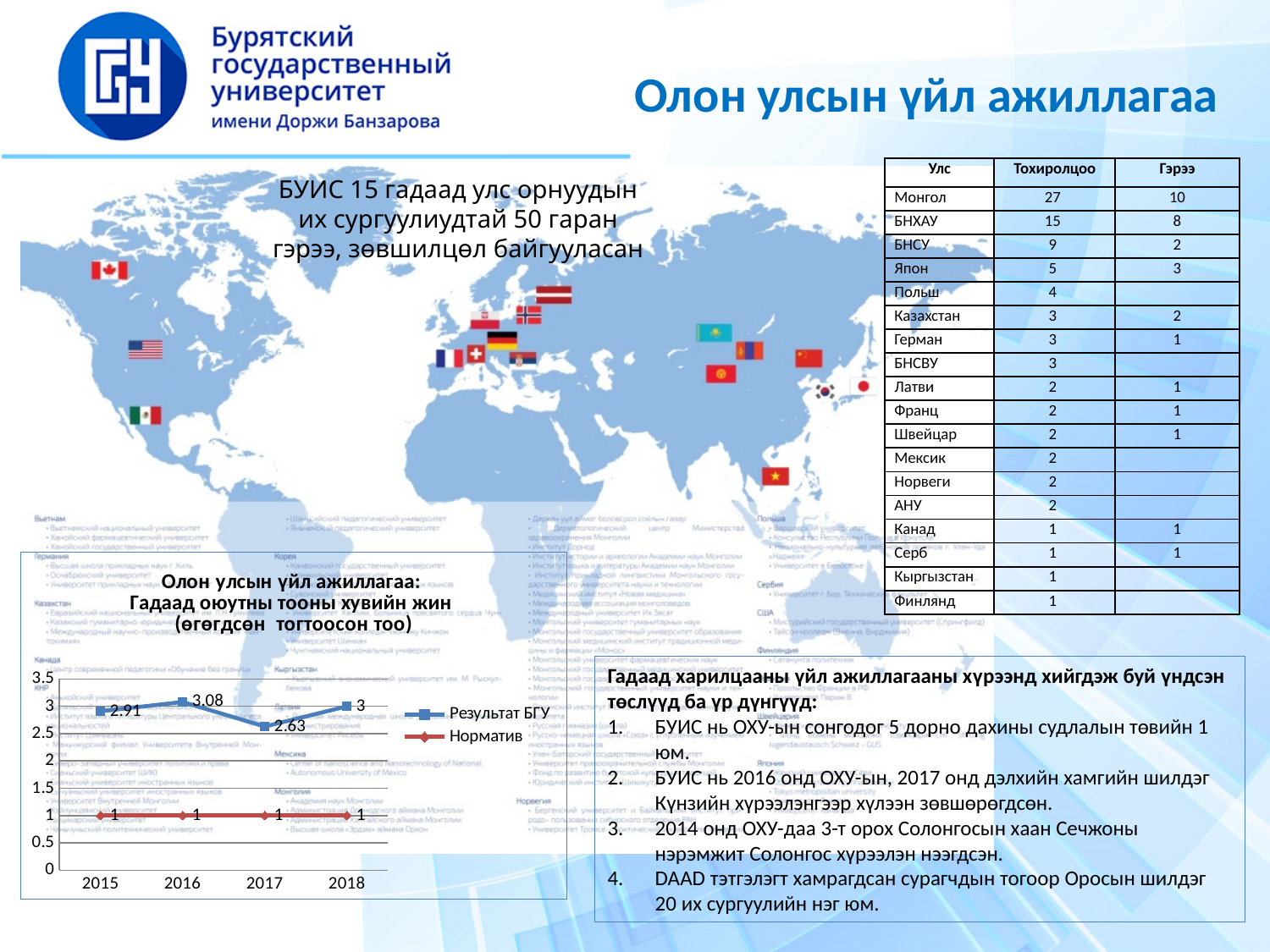
What is the value of Результат БГУ in 2018? 3 What is the value of Результат БГУ in 2016? 3.08 Which is larger: Результат БГУ in 2015 or in 2018? 2018 In which year is Результат БГУ lowest? 2017 What is the value of Результат БГУ in 2015? 2.91 What is the value of Результат БГУ in 2017? 2.63 What is the value of Норматив in 2017? 1 In which year is Результат БГУ highest? 2016 How many series does the legend list? 2 What kind of chart is shown on the slide? line chart How many years are shown on the x axis? 4 What is the difference between Результат БГУ in 2016 and in 2017? 0.45